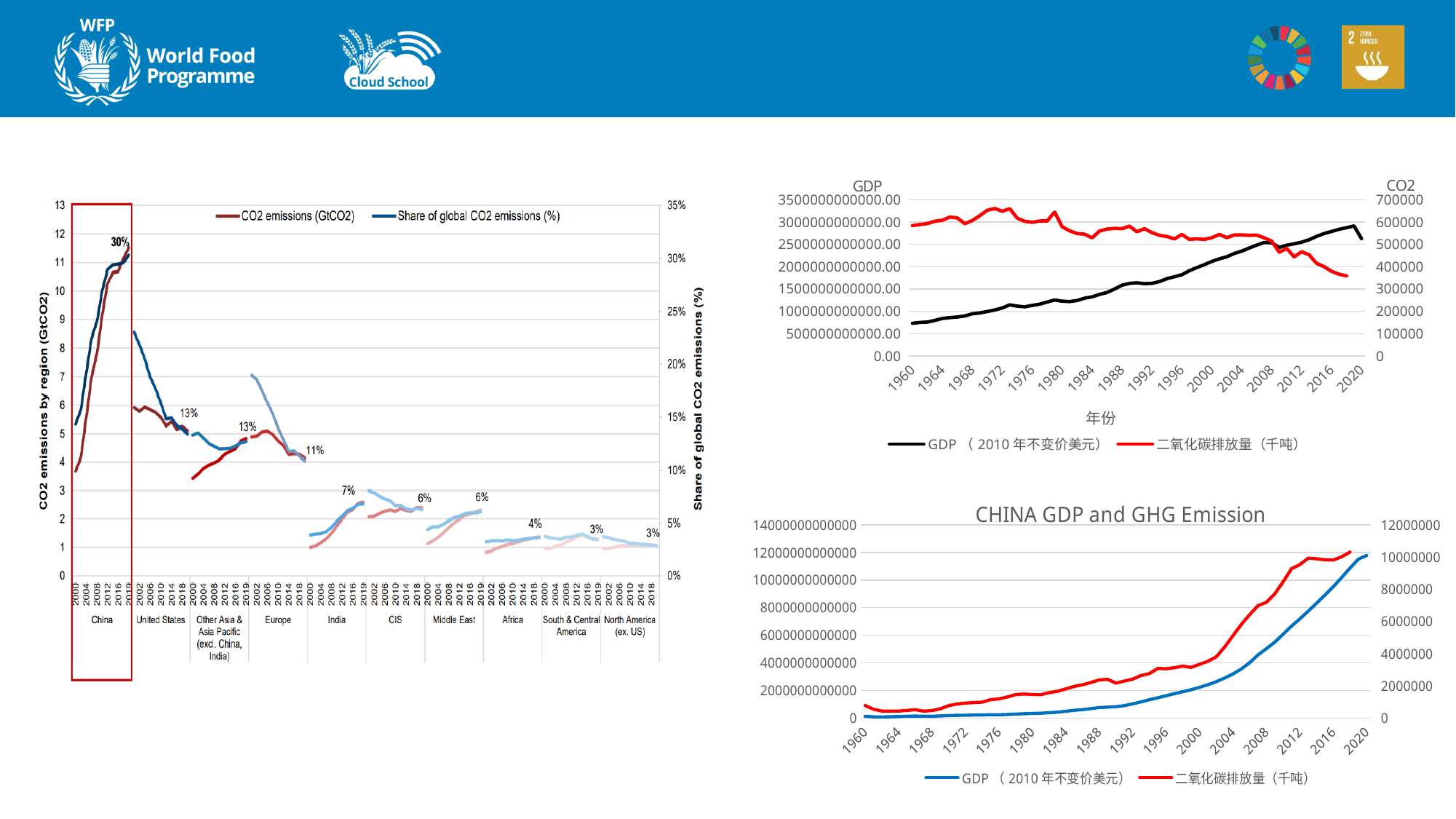
In the left chart, what share of global CO2 emissions is labelled for China? 30% In the left chart, what share of global CO2 emissions is labelled for India? 7% In the left chart, which has the larger labelled share of global CO2 emissions, Africa or Middle East? Middle East In the left chart, which region has the highest labelled share of global CO2 emissions? China In the top-right chart, does the GDP line rise or fall from 1960 to 2020? rises How many series does the legend of the left chart list? 2 What is the title of the bottom-right chart? CHINA GDP and GHG Emission In the top-right chart, does the CO2 emissions line rise or fall from 1960 to 2020? falls In the bottom-right chart 'CHINA GDP and GHG Emission', is the GDP value in 2020 greater or less than 10000000000000? greater In the left chart, what is the difference between the labelled shares for China and the United States? 17% What kind of chart is the bottom-right chart titled 'CHINA GDP and GHG Emission'? line chart How many regions are shown along the x axis of the left chart? 10